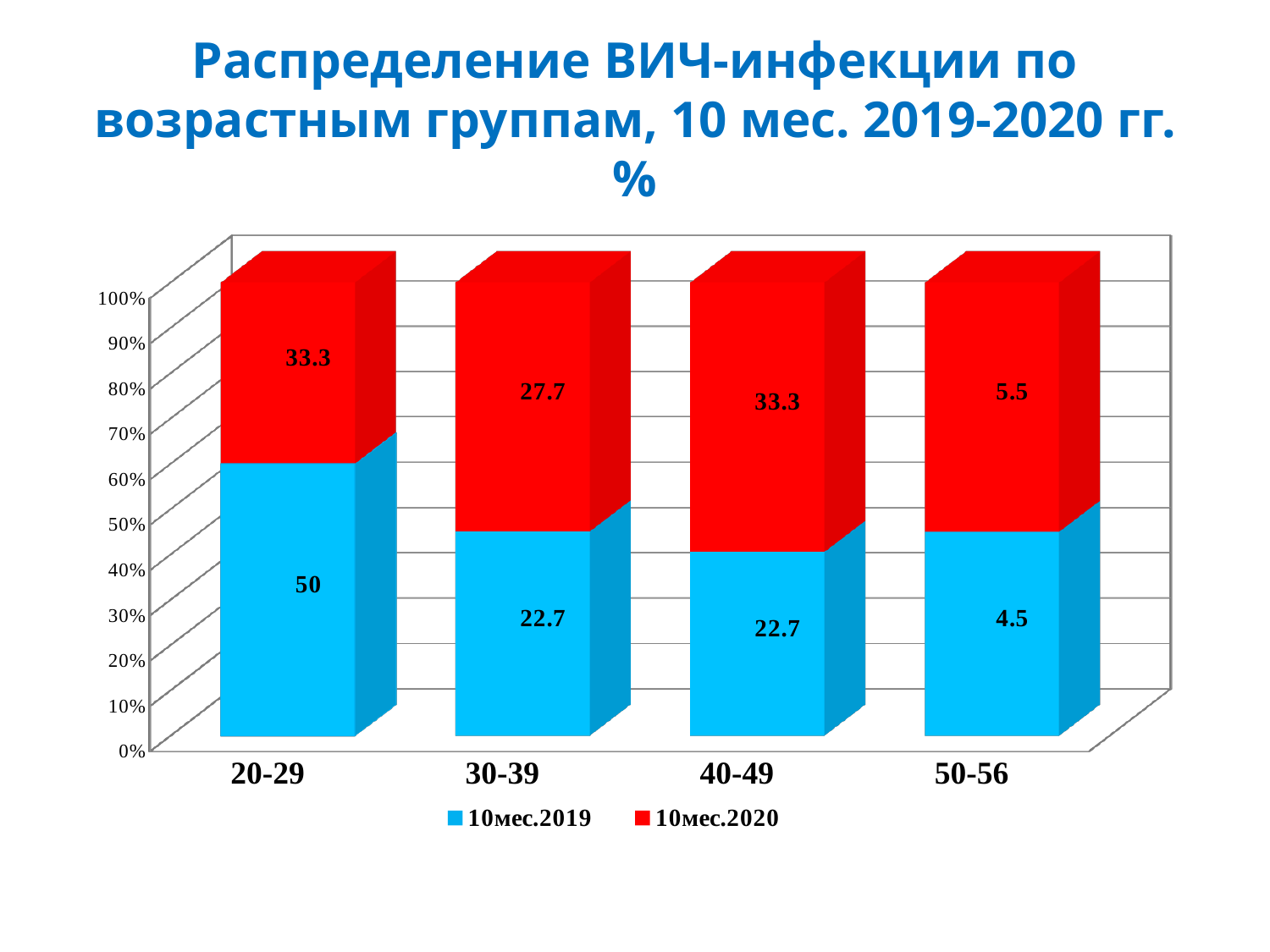
How many age groups are shown on the x axis? 4 Which age group has the lowest value in the 10мес.2020 series? 50-56 What is the value for the 30-39 age group in the 10мес.2020 series? 27.7 What kind of chart is shown on the slide? Stacked bar chart What is the value for the 50-56 age group in the 10мес.2019 series? 4.5 What is the value for the 20-29 age group in the 10мес.2019 series? 50 How many series does the legend list? 2 For the 30-39 age group, which series has the larger value, 10мес.2019 or 10мес.2020? 10мес.2020 What is the difference between the 10мес.2019 and 10мес.2020 values for the 20-29 age group? 16.7 Which age group has the highest value in the 10мес.2019 series? 20-29 What is the value for the 40-49 age group in the 10мес.2020 series? 33.3 Which colour represents the 10мес.2020 series? Red